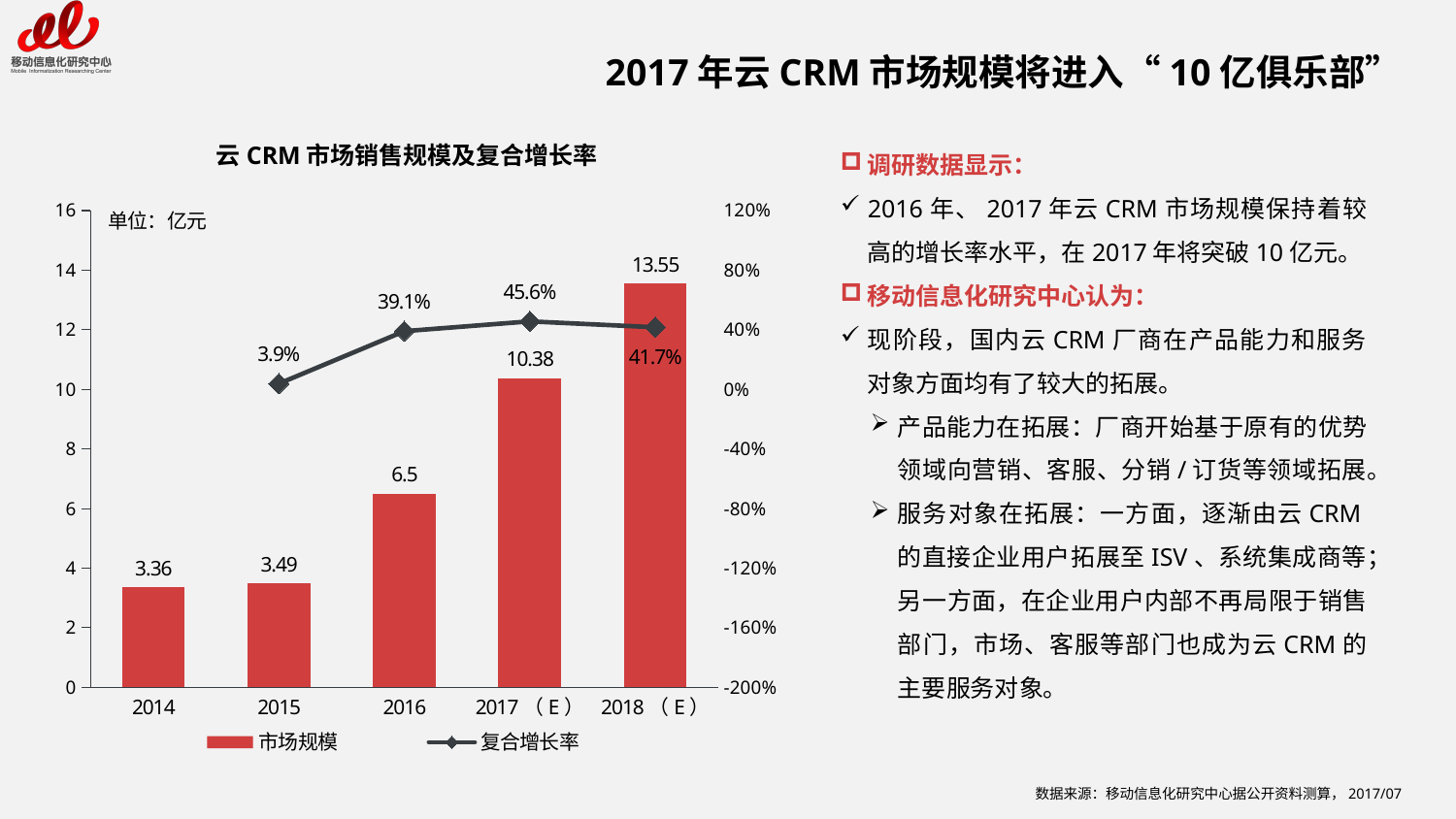
What is the market size (市场规模) value for 2016? 6.5 What is the compound growth rate (复合增长率) for 2017 (E)? 45.6% Which year has the highest market size (市场规模)? 2018 (E) What kind of chart is used to show the market size (市场规模) series? Bar chart Which is larger, the compound growth rate for 2016 or for 2018 (E)? 2018 (E) Does the market size (市场规模) rise or fall from 2014 to 2018 (E)? Rise Which year has the lowest market size (市场规模)? 2014 What is the market size (市场规模) value for 2018 (E)? 13.55 What is the difference in market size between 2017 (E) and 2016? 3.88 How many years are shown on the x axis? 5 What is the compound growth rate (复合增长率) for 2015? 3.9% How many series does the legend list? 2